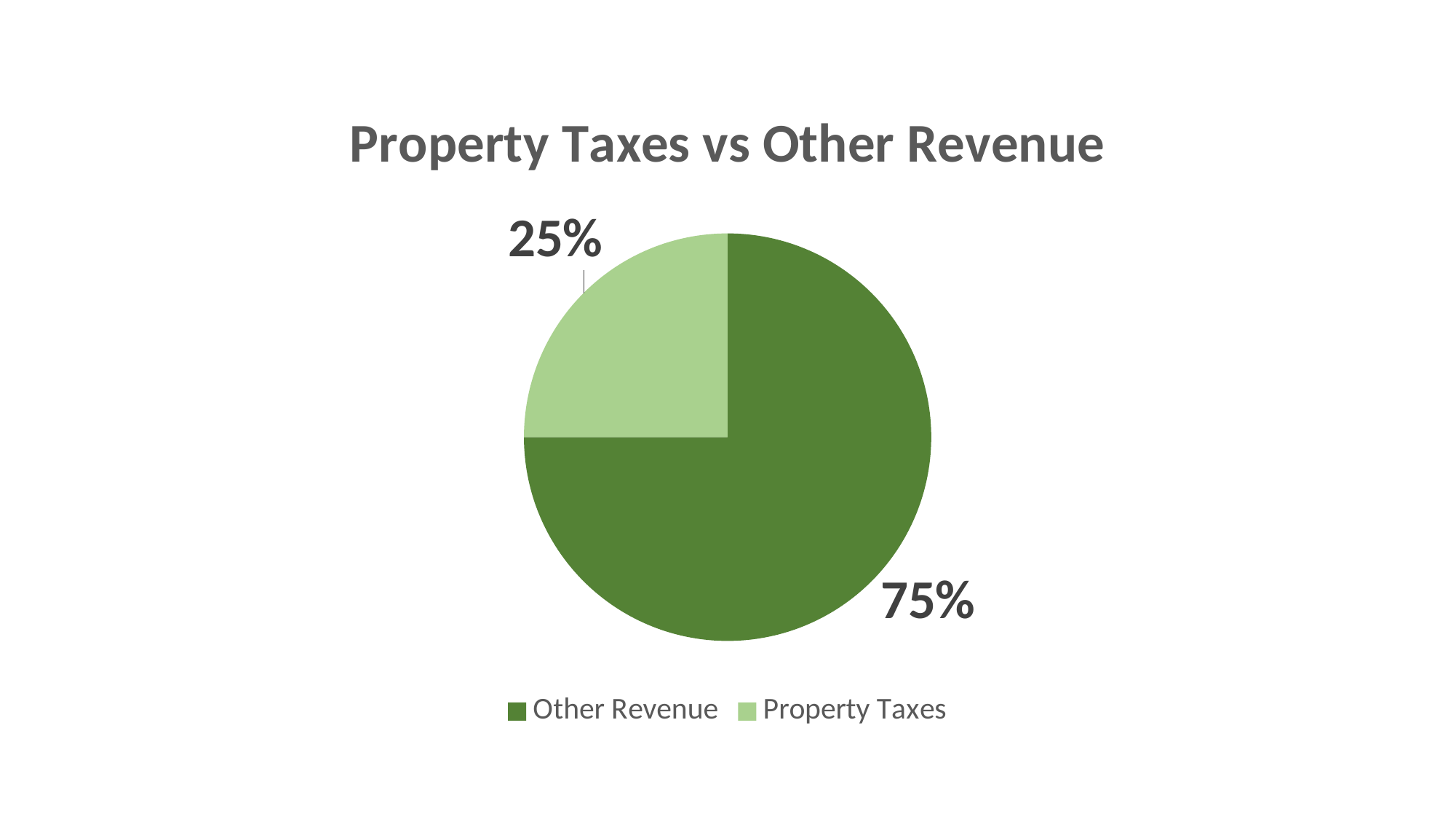
What is the difference in percentage points between Other Revenue and Property Taxes? 50 What share of the pie does Property Taxes represent? 25% Which category is shown in the lighter green colour? Property Taxes What share of the pie does Other Revenue represent? 75% Which is larger, Property Taxes or Other Revenue? Other Revenue How many slices does the pie chart have? 2 Which slice is the smallest? Property Taxes What is the title of the chart? Property Taxes vs Other Revenue Which slice is the largest? Other Revenue What is the total of the two slices shown? 100% What kind of chart is shown on the slide? Pie chart